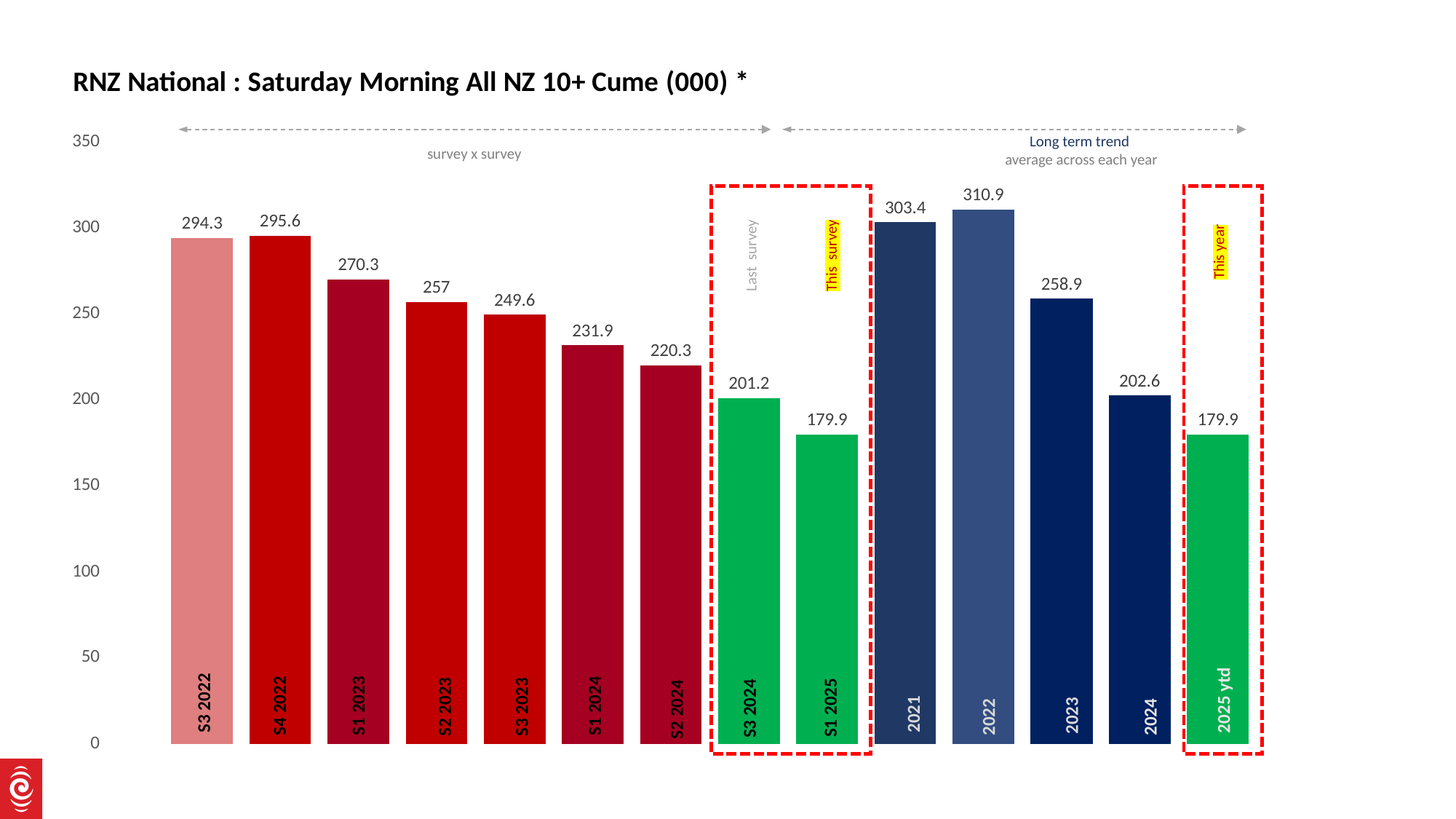
Do the survey x survey values rise or fall from S4 2022 to S1 2025? fall Which is larger, the value for S4 2022 or the value for S3 2022? S4 2022 What is the value for S1 2025? 179.9 What is the difference between the 2021 and 2022 yearly averages? 7.5 Which survey in the survey x survey section has the lowest value? S1 2025 What is the value for S3 2024? 201.2 How many bars are plotted on the chart? 14 Which bar has the highest value on the chart? 2022 What is the difference between S3 2024 and S1 2025? 21.3 What type of chart is shown on the slide? bar chart What is the value for S2 2023? 257 What is the value for the 2022 yearly average? 310.9